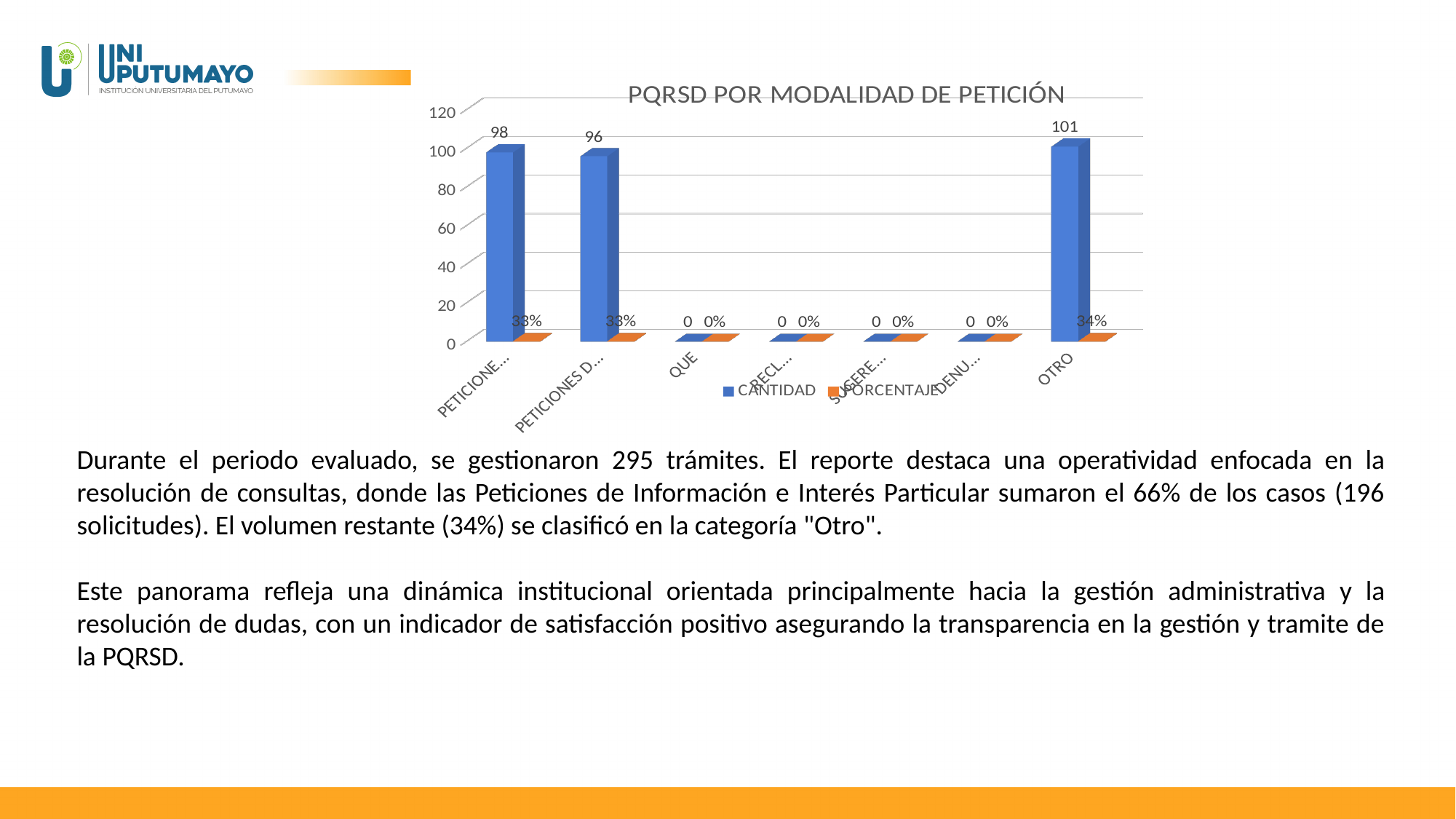
How many categories have a CANTIDAD value of 0? 4 What is the CANTIDAD value for the OTRO category? 101 How many categories are shown on the x axis of the chart? 7 What type of chart is shown on the slide? bar chart What is the difference between the CANTIDAD value for OTRO and the CANTIDAD value of the leftmost bar? 3 What is the title of the chart? PQRSD POR MODALIDAD DE PETICIÓN How many series does the legend of the chart list? 2 What is the CANTIDAD value of the leftmost bar in the chart? 98 What is the PORCENTAJE value for the OTRO category? 34% Which category has the highest CANTIDAD value? OTRO Which is larger: the CANTIDAD value of the leftmost bar or the CANTIDAD value for OTRO? OTRO What is the CANTIDAD value of the second bar from the left? 96